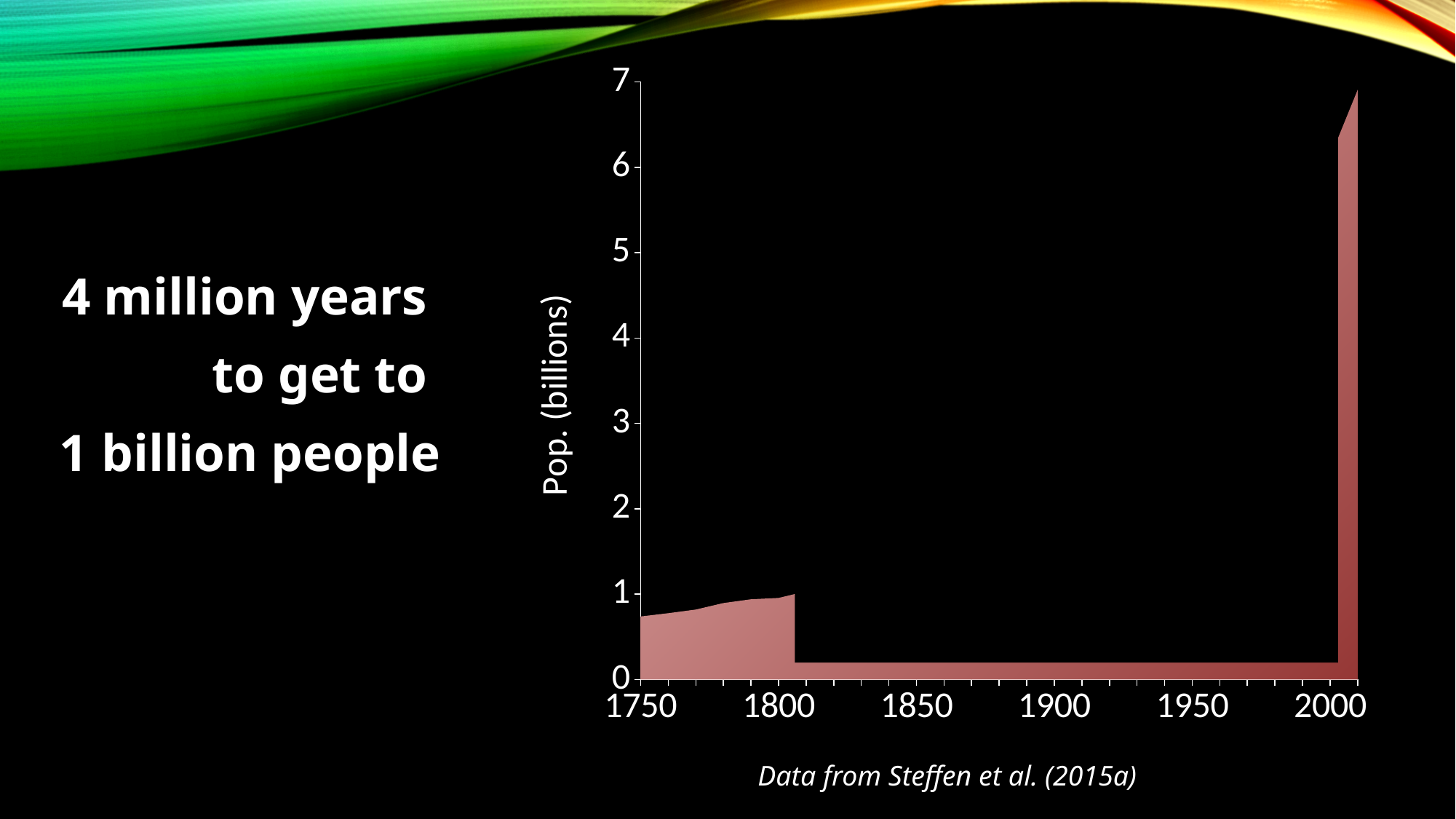
What is the highest value shown on the vertical axis of the chart? 7 Is the population value at 1900 greater or less than 1 billion? less What is the source note printed below the chart? Data from Steffen et al. (2015a) What is the last year labelled on the horizontal axis of the chart? 2000 How many year labels are printed along the horizontal axis of the chart? 6 Does the plotted population rise or fall between 1750 and 1800? rise What kind of chart is shown on the slide? area chart Is the population value at 1750 greater or less than 1 billion? less Is the highest population value plotted on the chart greater or less than 6 billion? greater What is the first year labelled on the horizontal axis of the chart? 1750 What is the label on the vertical axis of the chart? Pop. (billions) At which end of the horizontal axis does the chart reach its highest population value, the left (1750) or the right (2000)? right (2000)